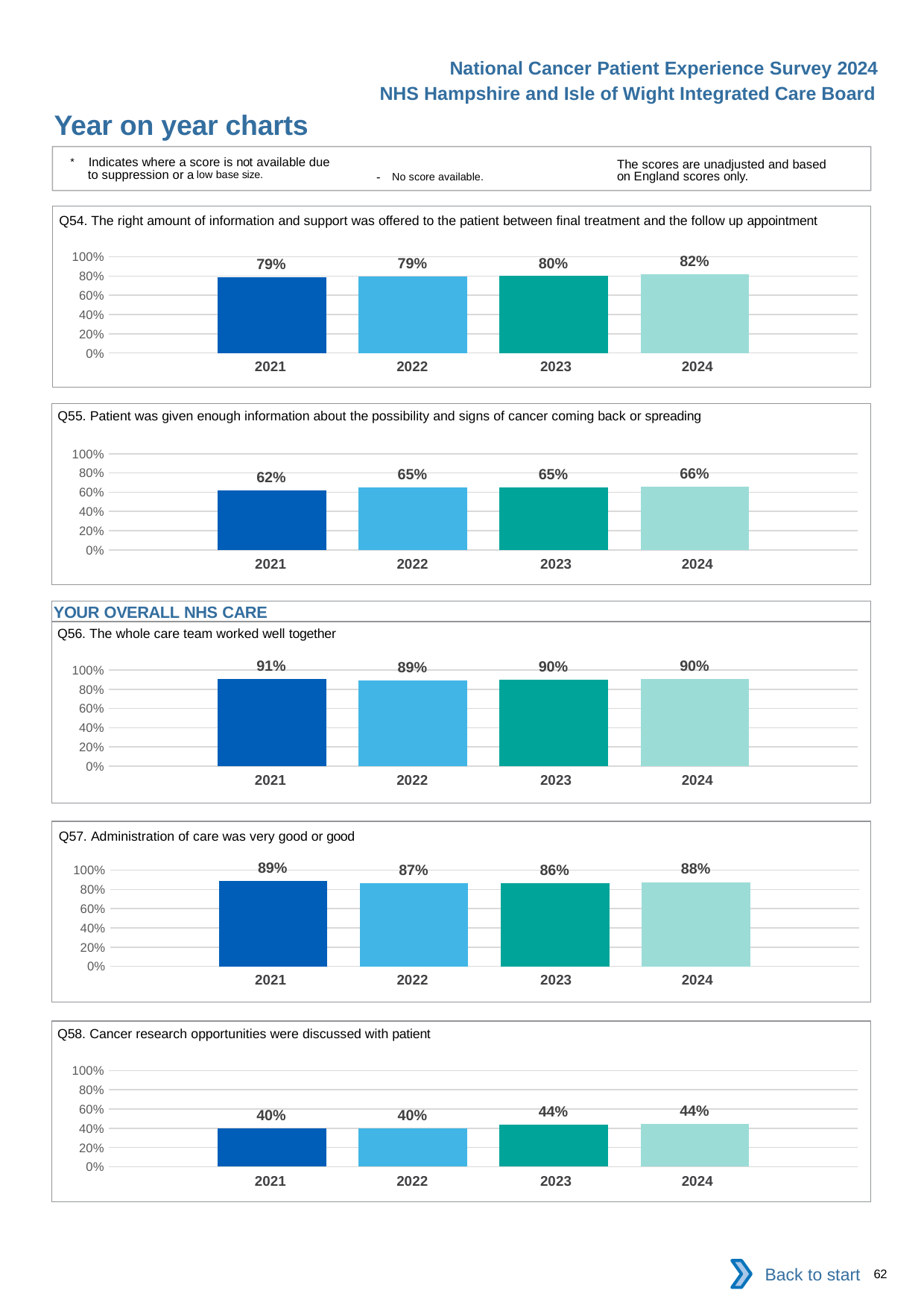
What kind of chart is the Q55 chart? bar chart In the Q55 chart, which year has the lowest value? 2021 In the Q54 chart, what is the value for 2024? 82% What is the section heading shown above the Q56 chart? YOUR OVERALL NHS CARE In the Q56 chart, what is the value for 2021? 91% In the Q57 chart, what is the value for 2022? 87% In the Q54 chart, which year has the highest value? 2024 In the Q57 chart, what is the difference between the 2021 value and the 2023 value? 3% In the Q58 chart, which is larger, the value for 2022 or the value for 2023? 2023 In the Q55 chart, do the values rise or fall from 2021 to 2024? rise In the Q58 chart, is the value for 2021 greater or less than 60%? less How many years are shown in the Q54 chart? 4